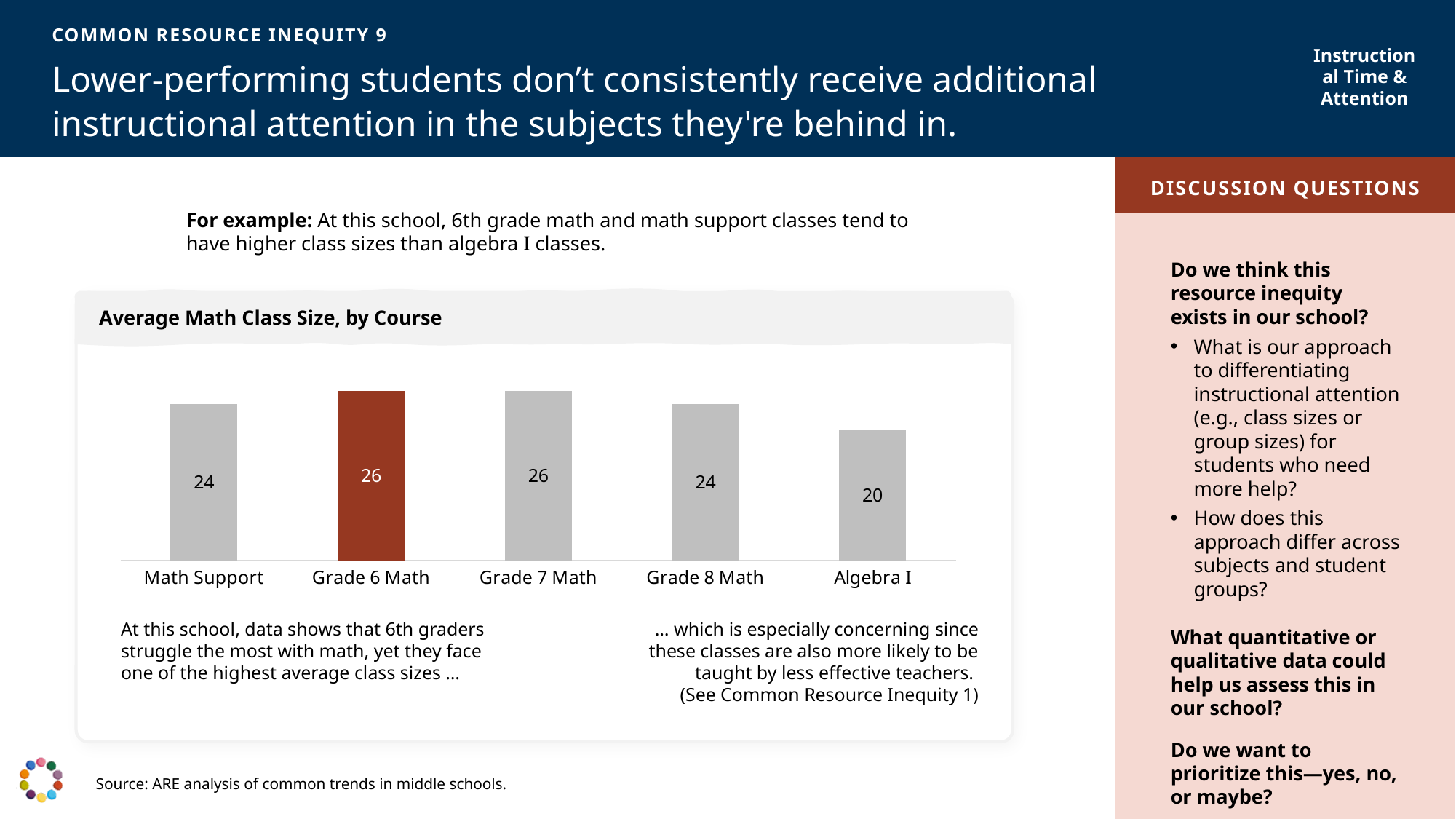
Which has a larger average class size, Math Support or Algebra I? Math Support What is the average class size for Grade 8 Math? 24 What is the difference in average class size between Grade 7 Math and Grade 8 Math? 2 Which bar in the chart is highlighted in a different colour (dark red)? Grade 6 Math What is the average class size for Algebra I? 20 How many courses are shown in the chart? 5 What kind of chart is used to show average math class size? Bar chart Which course has the lowest average class size? Algebra I Which has a larger average class size, Grade 6 Math or Grade 8 Math? Grade 6 Math What is the difference in average class size between Grade 6 Math and Algebra I? 6 What is the title of the chart? Average Math Class Size, by Course What is the average class size for Math Support? 24